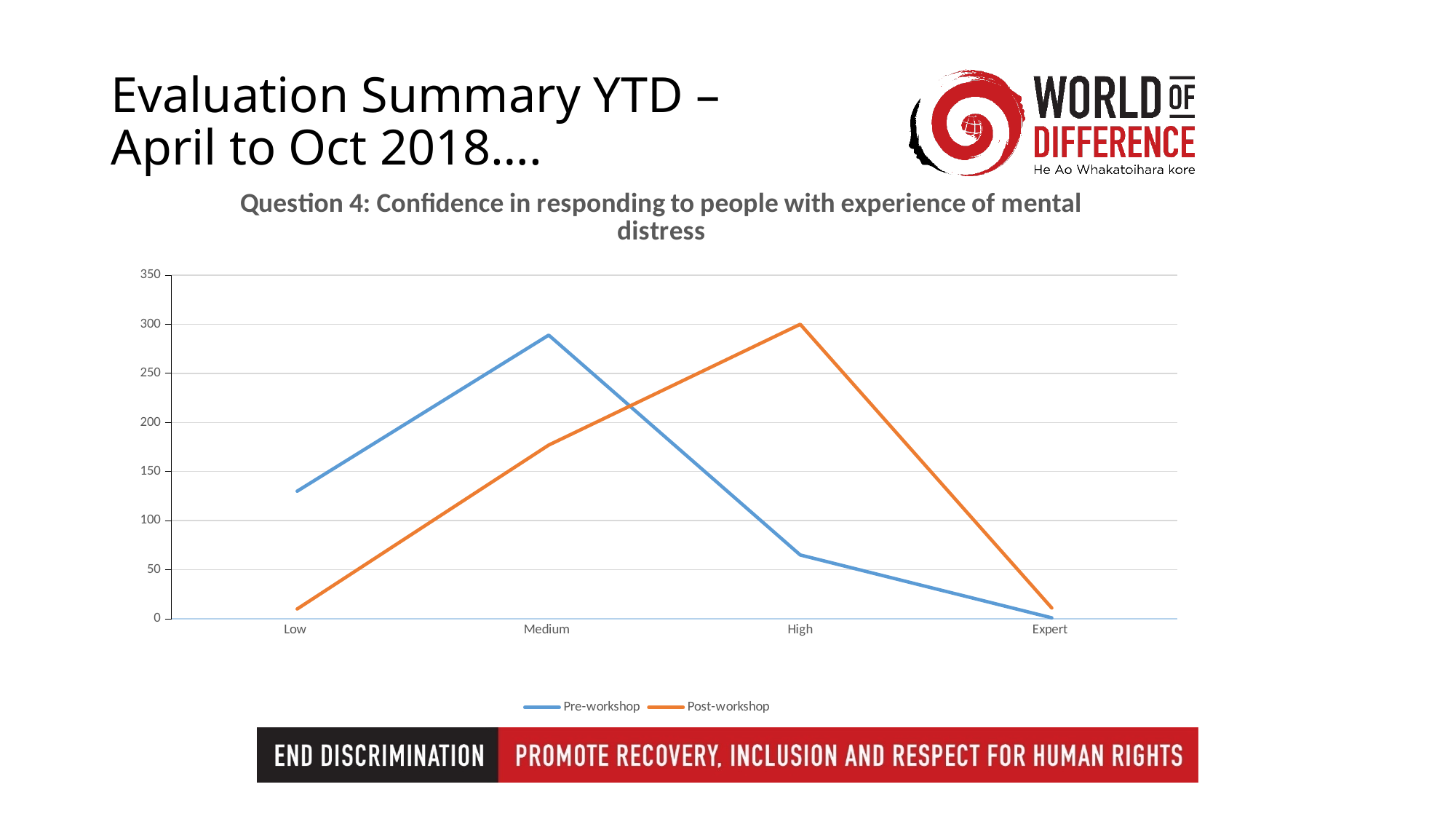
At the Low category, which series has the larger value, Pre-workshop or Post-workshop? Pre-workshop For the Post-workshop series, which category has the highest value? High Is the Pre-workshop value for Medium greater or less than 250? greater At the High category, which series has the larger value, Pre-workshop or Post-workshop? Post-workshop How many series does the legend list? 2 For the Pre-workshop series, which category has the lowest value? Expert What is the title of the chart? Question 4: Confidence in responding to people with experience of mental distress How many categories are shown on the x axis? 4 For the Pre-workshop series, which category has the highest value? Medium What kind of chart is shown on the slide? line chart Does the Post-workshop line rise or fall from Low to High? rises Is the Post-workshop value for Low greater or less than 50? less